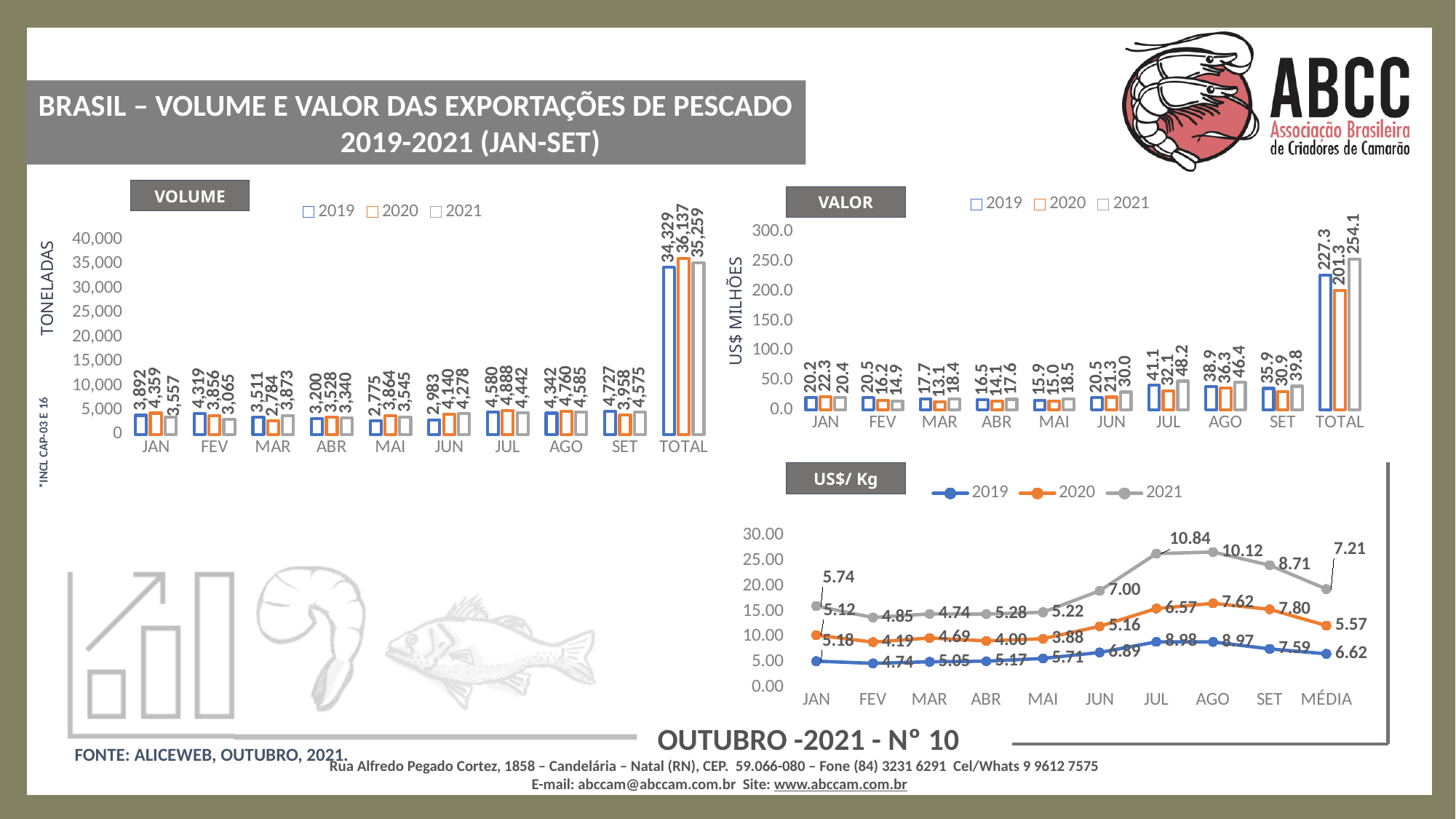
In the US$/ Kg chart, what is the value for 2021 in JUL? 10.84 In the VALOR chart, what is the difference between the 2021 TOTAL and the 2020 TOTAL? 52.8 In the VOLUME chart, how many series does the legend list? 3 In the US$/ Kg chart, what is the MÉDIA value for 2019? 6.62 In the VALOR chart, which is larger in JUL: the 2019 value or the 2020 value? 2019 In the VOLUME chart, which year has the highest TOTAL volume? 2020 In the VOLUME chart, what is the TOTAL value for 2020? 36,137 In the VALOR chart, which month has the highest value for 2021 (excluding TOTAL)? JUL In the VALOR chart, what is the TOTAL value for 2021? 254.1 What kind of chart is the US$/ Kg chart? line chart In the VOLUME chart, how many categories are shown on the x axis? 10 In the VOLUME chart, what is the value for 2019 in SET? 4,727